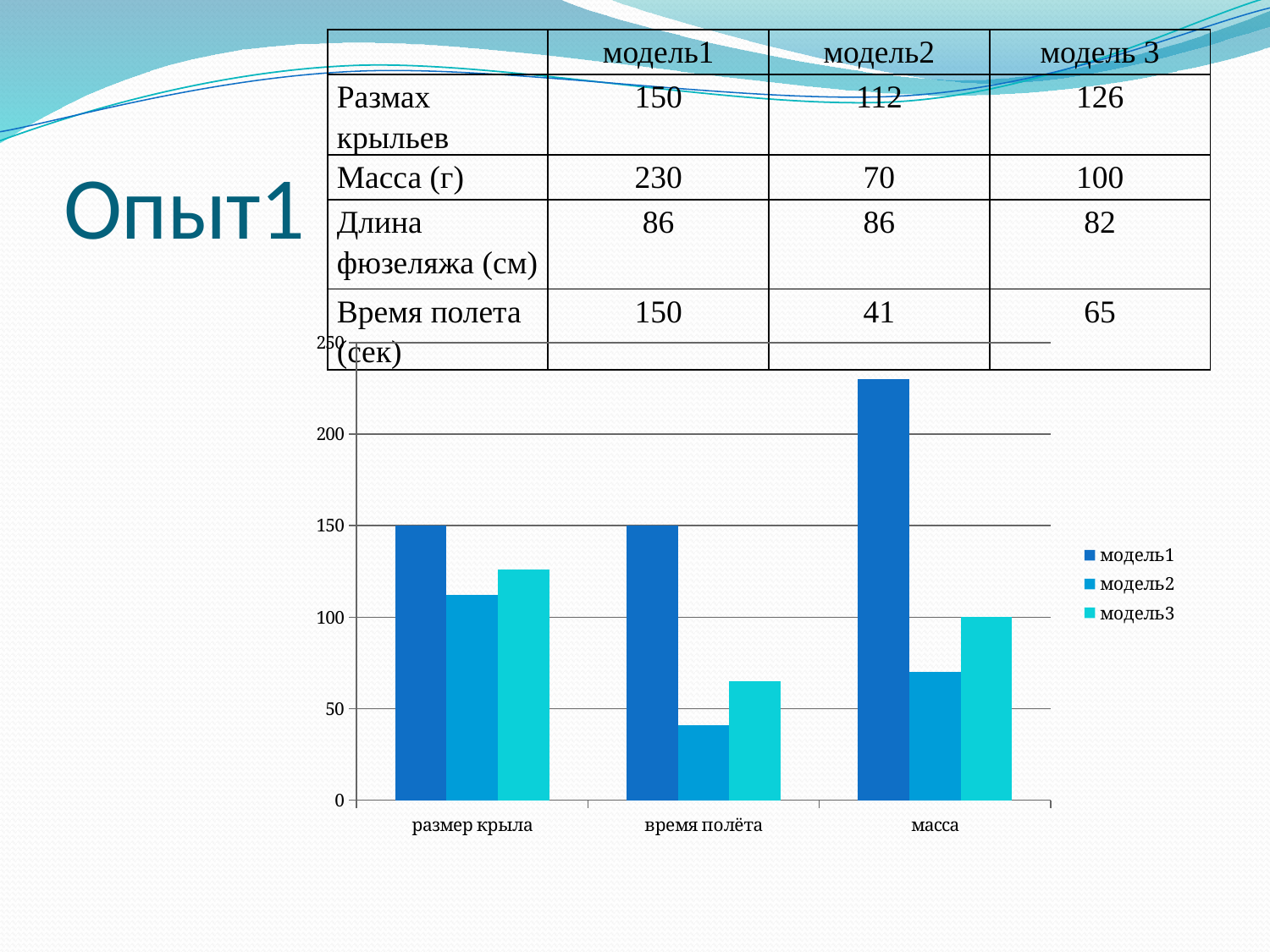
What kind of chart is shown on the slide? bar chart How many series does the chart legend list? 3 What are the entries listed in the chart legend? модель1, модель2, модель3 What is the value for модель1 in the category размер крыла? 150 Is the value for модель3 in the category время полёта greater or less than 50? greater Which series has the lowest value in the category время полёта? модель2 In the category размер крыла, which is larger: модель2 or модель3? модель3 Is the value for модель1 in the category масса greater or less than 200? greater Which series has the highest value in the category масса? модель1 What is the value for модель3 in the category масса? 100 How many categories are shown on the x axis of the chart? 3 Is the value for модель2 in the category время полёта greater or less than 50? less